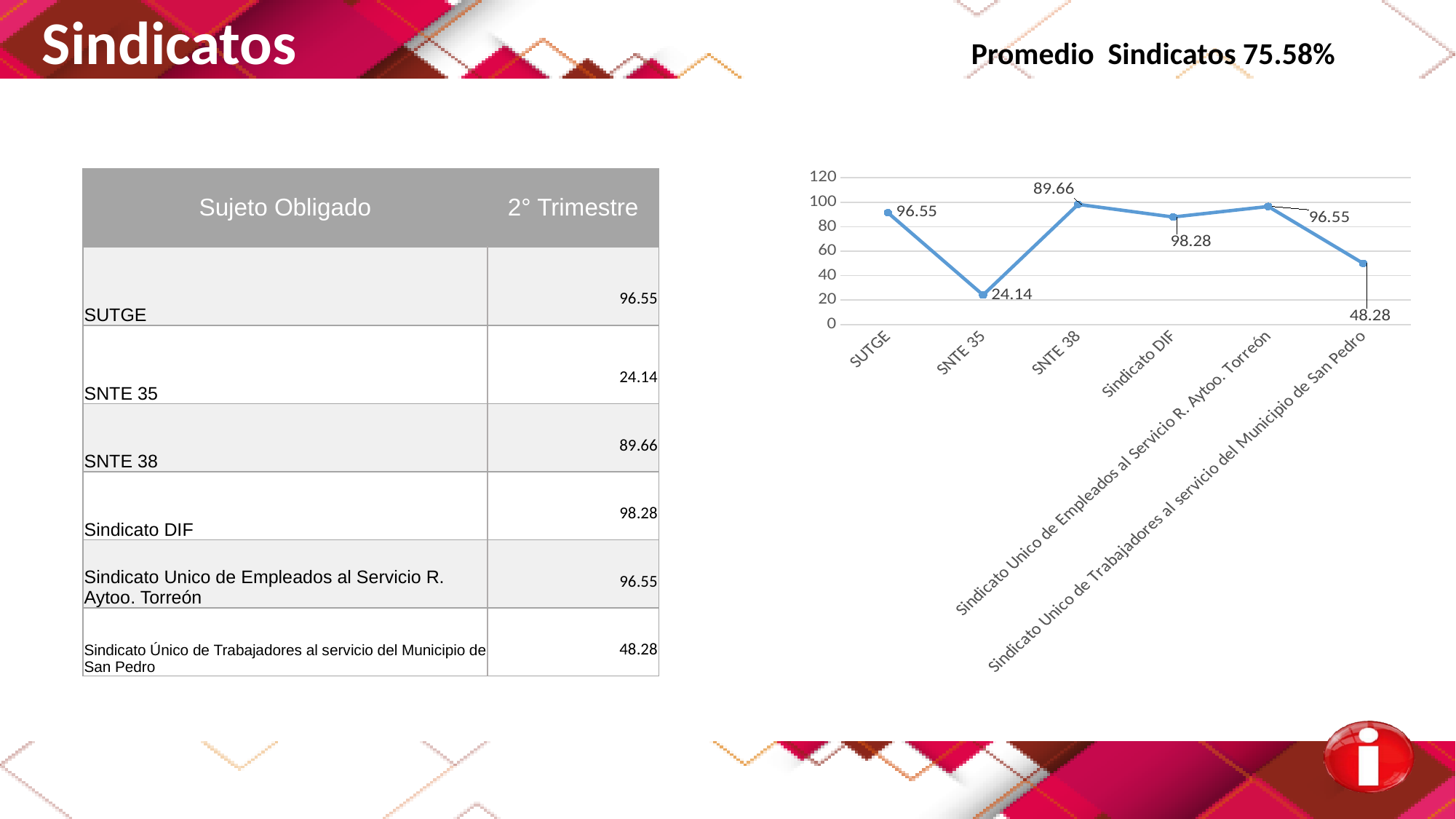
What average (Promedio) for Sindicatos is stated at the top of the slide? 75.58% How many categories are plotted along the x axis of the chart? 6 Does the line rise or fall from Sindicato Unico de Empleados al Servicio R. Aytoo. Torreón to Sindicato Unico de Trabajadores al servicio del Municipio de San Pedro? fall What is the value plotted for SNTE 35? 24.14 What is the value plotted for Sindicato Unico de Trabajadores al servicio del Municipio de San Pedro? 48.28 What kind of chart is shown on the slide? line chart What is the value plotted for SUTGE? 96.55 Which has the larger value, SUTGE or Sindicato Unico de Trabajadores al servicio del Municipio de San Pedro? SUTGE Is the value for SNTE 35 greater or less than 40? less What is the difference between the values for SUTGE and Sindicato Unico de Trabajadores al servicio del Municipio de San Pedro? 48.27 Which category has the lowest value in the chart? SNTE 35 What is the difference between the values for SUTGE and SNTE 35? 72.41